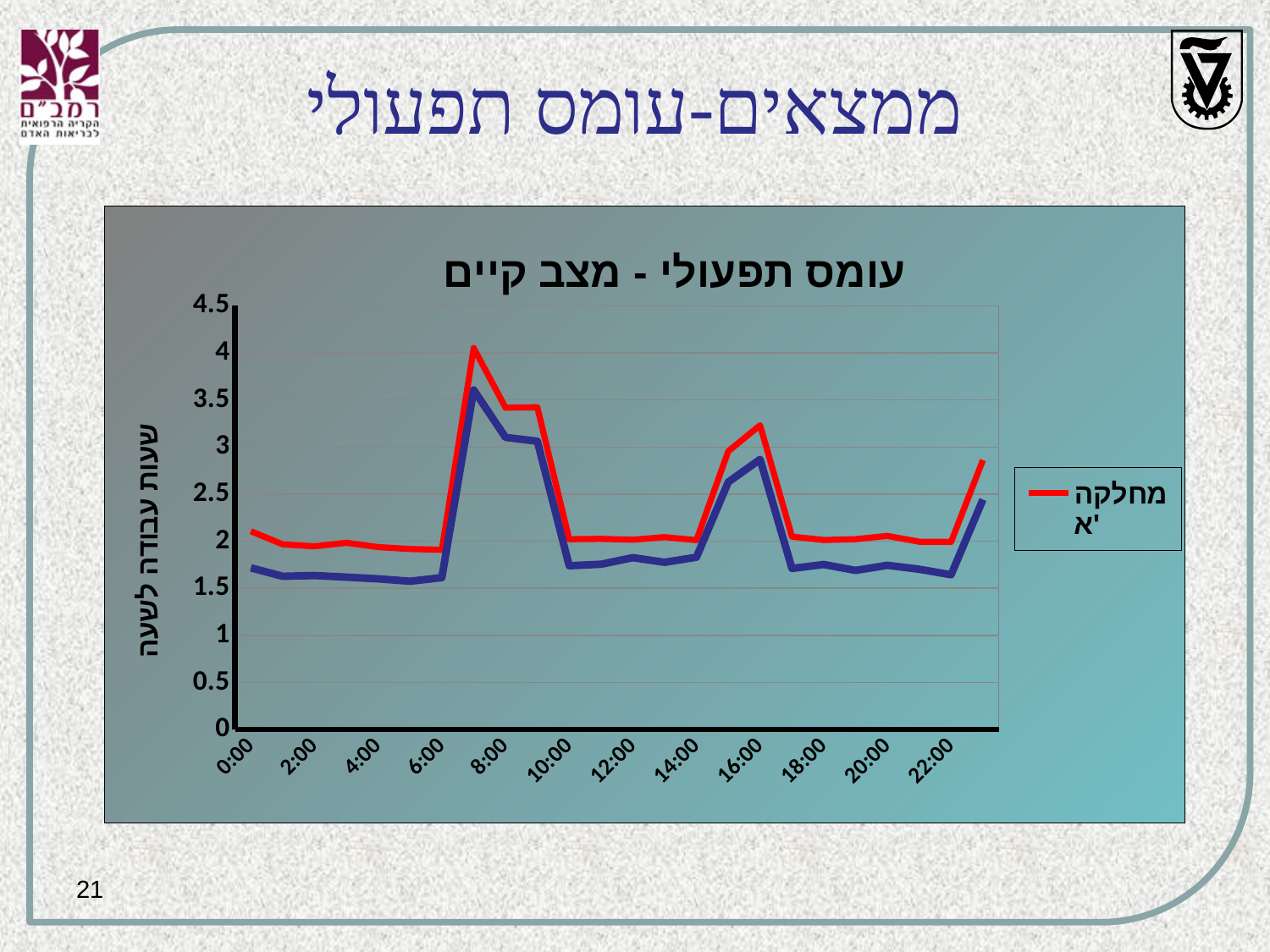
Is the value of the blue line at 0:00 greater or less than 1.5? greater Is the value of the red line at 8:00 greater or less than 3? greater Is the value of the red line at 16:00 greater or less than 3? greater What kind of chart is shown on the slide? line chart Which line is higher at 8:00, the red line or the blue line? red How many time labels are shown on the x axis? 12 What is the title of the chart? עומס תפעולי - מצב קיים Do the values of the red line rise or fall between 8:00 and 10:00? fall What is the label of the series listed in the legend? מחלקה א' How many series does the chart's legend list? 1